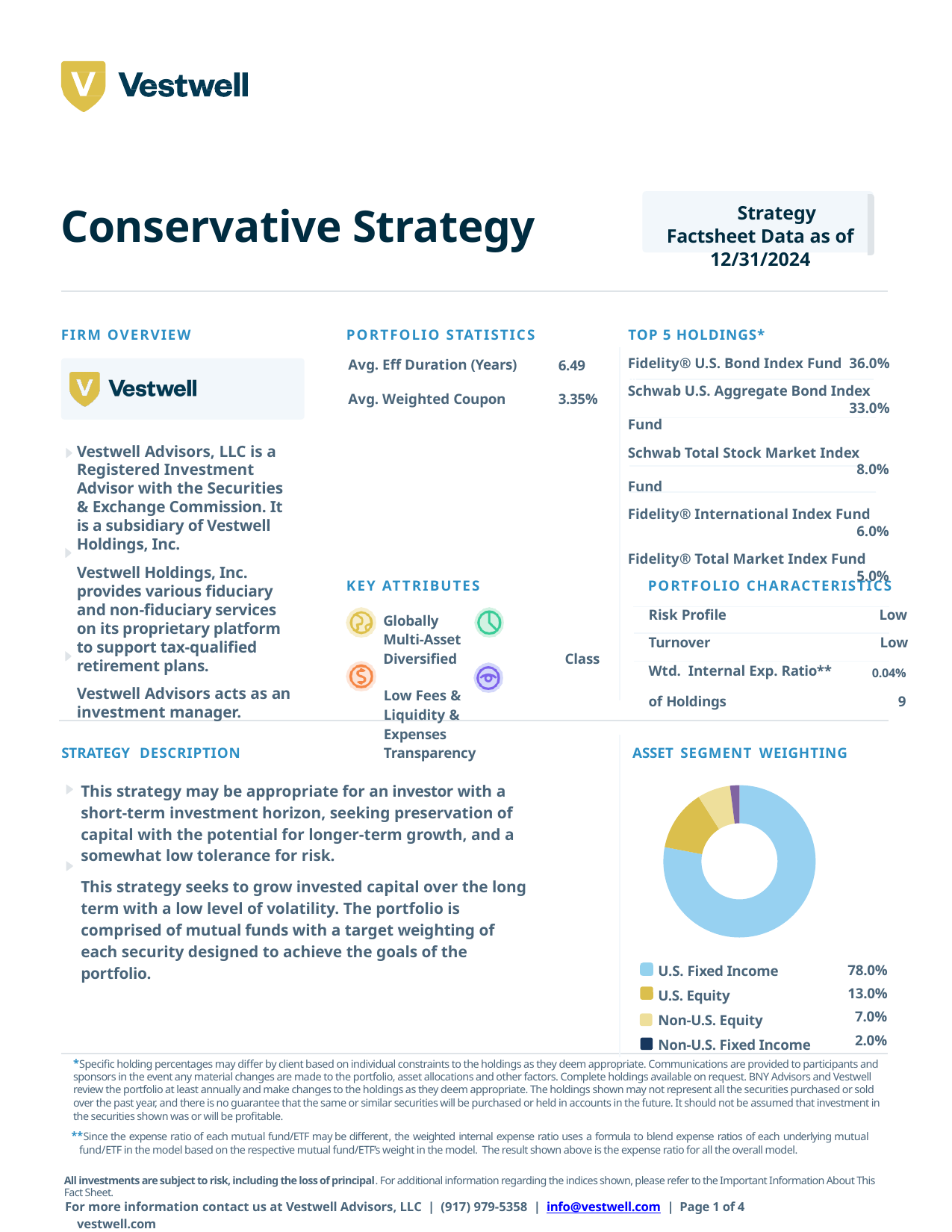
In the Asset Segment Weighting chart, which is larger: U.S. Equity or Non-U.S. Equity? U.S. Equity In the Asset Segment Weighting chart, what is the weighting for Non-U.S. Fixed Income? 2.0% In the Asset Segment Weighting chart, which segment has the smallest weighting? Non-U.S. Fixed Income In the Asset Segment Weighting chart, what colour represents U.S. Fixed Income? Light blue In the Asset Segment Weighting chart, how many segments are shown? 4 What kind of chart is shown under Asset Segment Weighting? Doughnut chart In the Asset Segment Weighting chart, what is the difference between the U.S. Fixed Income and U.S. Equity weightings? 65.0% In the Asset Segment Weighting chart, what is the weighting for U.S. Equity? 13.0% In the Asset Segment Weighting chart, what share of the pie does Non-U.S. Equity represent? 7.0% In the Asset Segment Weighting chart, what is the weighting for U.S. Fixed Income? 78.0% In the Asset Segment Weighting chart, which segment has the largest weighting? U.S. Fixed Income In the Asset Segment Weighting chart, what is the weighting for Non-U.S. Equity? 7.0%